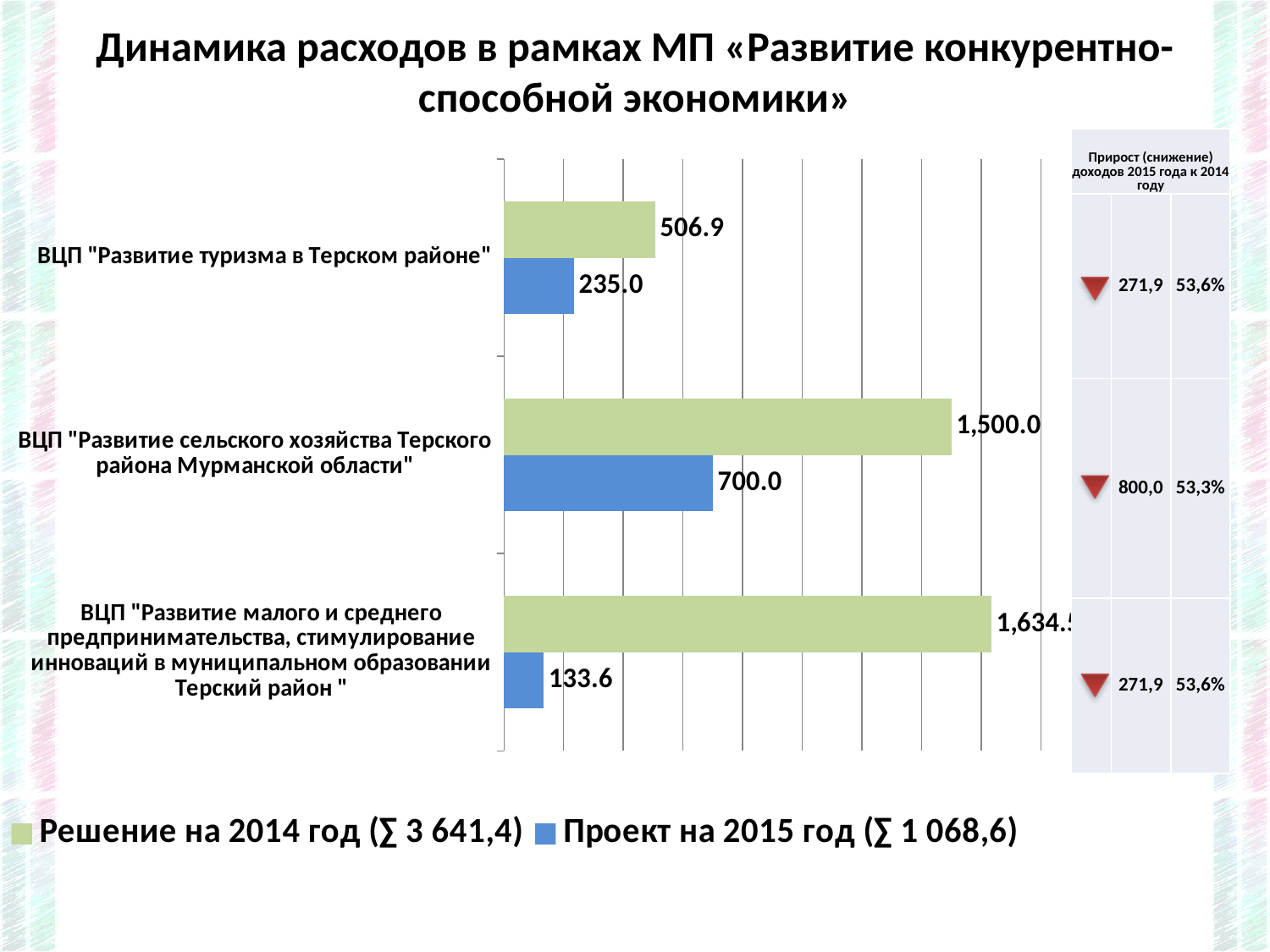
What kind of chart is shown on the slide? bar chart Which category has the highest value for "Решение на 2014 год"? ВЦП "Развитие малого и среднего предпринимательства, стимулирование инноваций в муниципальном образовании Терский район" What is the difference between "Решение на 2014 год" and "Проект на 2015 год" for ВЦП "Развитие сельского хозяйства Терского района Мурманской области"? 800.0 What is the value of "Решение на 2014 год" for ВЦП "Развитие туризма в Терском районе"? 506.9 What total is shown in the legend for the series "Проект на 2015 год"? ∑ 1 068,6 What is the value of "Решение на 2014 год" for ВЦП "Развитие сельского хозяйства Терского района Мурманской области"? 1,500.0 How many series does the legend list? 2 For ВЦП "Развитие туризма в Терском районе", which is larger: "Решение на 2014 год" or "Проект на 2015 год"? Решение на 2014 год How many categories are plotted on the chart? 3 Which category has the lowest value for "Проект на 2015 год"? ВЦП "Развитие малого и среднего предпринимательства, стимулирование инноваций в муниципальном образовании Терский район" What is the value of "Проект на 2015 год" for ВЦП "Развитие малого и среднего предпринимательства, стимулирование инноваций в муниципальном образовании Терский район"? 133.6 What is the value of "Проект на 2015 год" for ВЦП "Развитие туризма в Терском районе"? 235.0